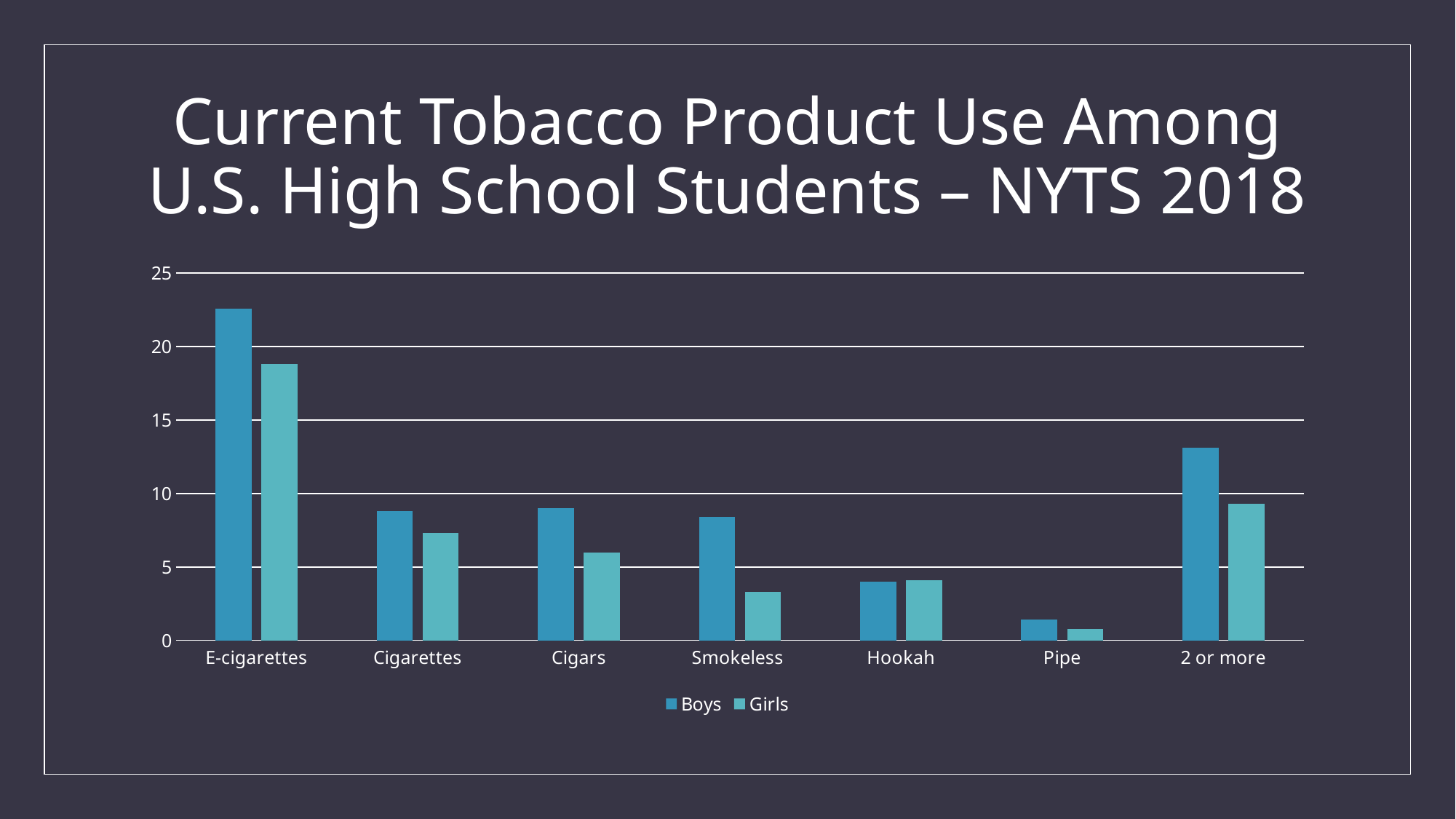
Is the value for Boys for E-cigarettes greater or less than 20? greater What are the two series named in the legend? Boys and Girls Which product category has the lowest value for Boys? Pipe Which product category has the lowest value for Girls? Pipe For Smokeless, which is larger, the value for Boys or the value for Girls? Boys How many product categories are shown on the x axis? 7 Which product category has the highest value for Boys? E-cigarettes Is the value for Girls for Smokeless greater or less than 5? less What kind of chart is shown on the slide? Bar chart Is the value for Boys for Cigarettes greater or less than 10? less How many series does the legend list? 2